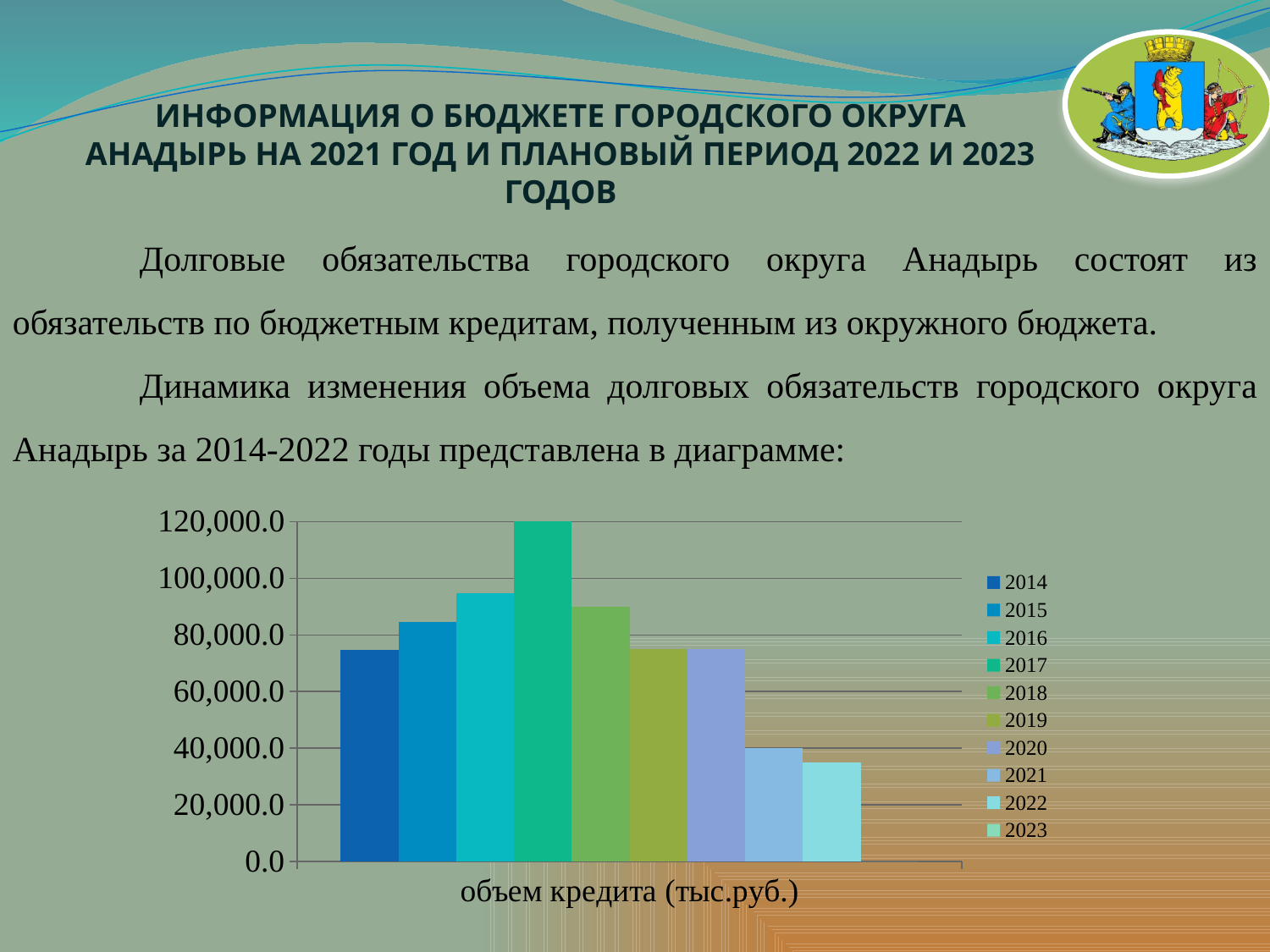
How many series does the legend list? 10 Which is larger, the value for 2015 or the value for 2016? 2016 What is the label shown on the horizontal axis of the chart? объем кредита (тыс.руб.) Do the values rise or fall from 2017 to 2022? fall Which year has the highest value in the chart? 2017 Is the value for 2018 greater or less than 80,000.0? greater Is the value for 2016 greater or less than 80,000.0? greater Is the value for 2014 greater or less than 80,000.0? less Which is larger, the value for 2018 or the value for 2019? 2018 What kind of chart is shown on the slide? bar chart What is the value for 2017 in the chart? 120,000.0